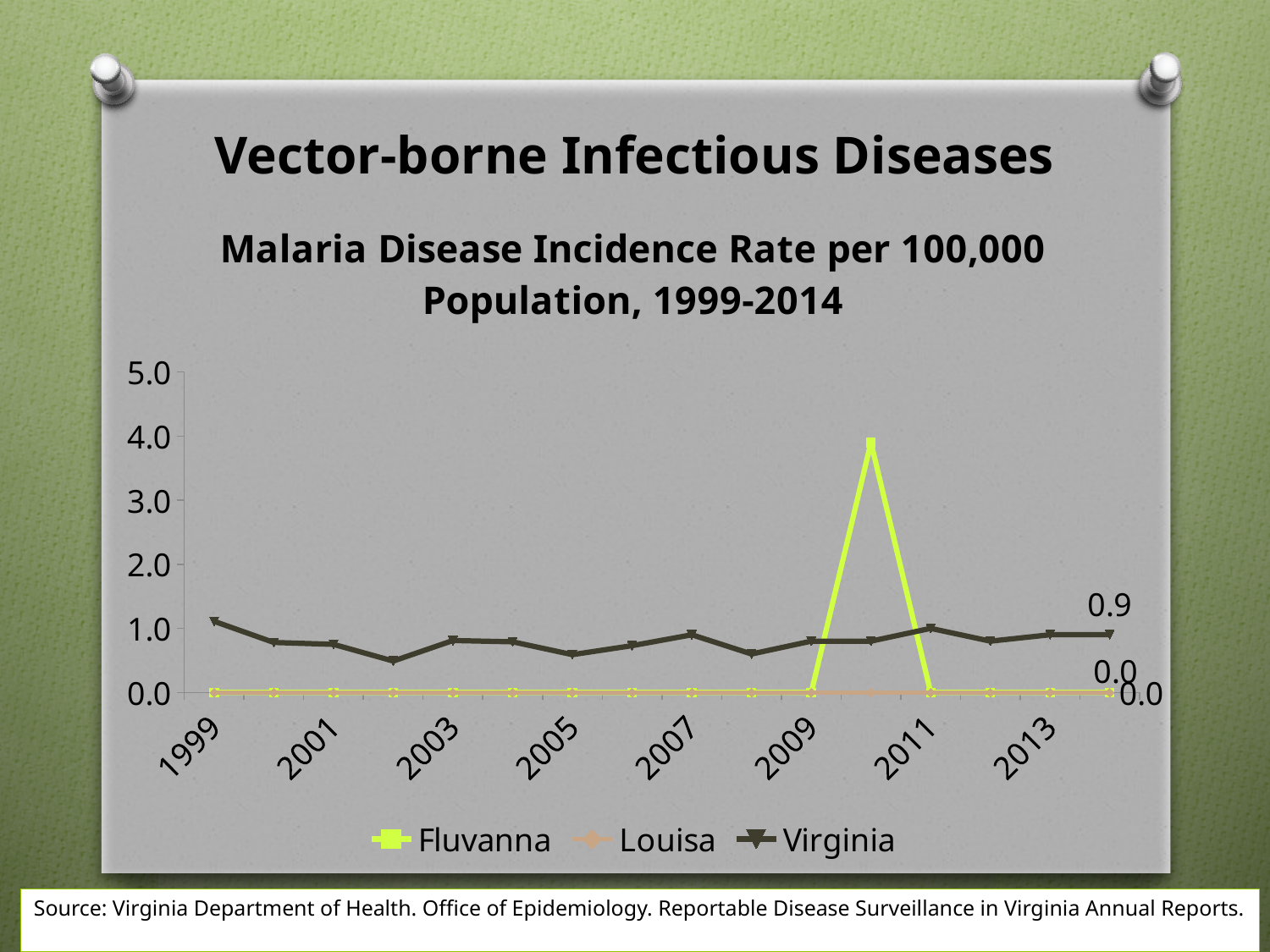
In which year does Fluvanna reach its highest value? 2010 What is the malaria incidence rate for Virginia in 2014? 0.9 What is the malaria incidence rate for Louisa in 2014? 0.0 Which series are listed in the legend? Fluvanna, Louisa, Virginia What is the malaria incidence rate for Fluvanna in 2014? 0.0 Is the value for Virginia in 2002 greater or less than 1.0? less What is the difference between the Virginia and Fluvanna values in 2014? 0.9 What kind of chart is shown on the slide? line chart Which series reaches the highest value anywhere on the chart? Fluvanna Is the value for Fluvanna in 2010 greater or less than 3.0? greater In 2014, which is larger, the value for Virginia or the value for Fluvanna? Virginia How many series does the legend list? 3